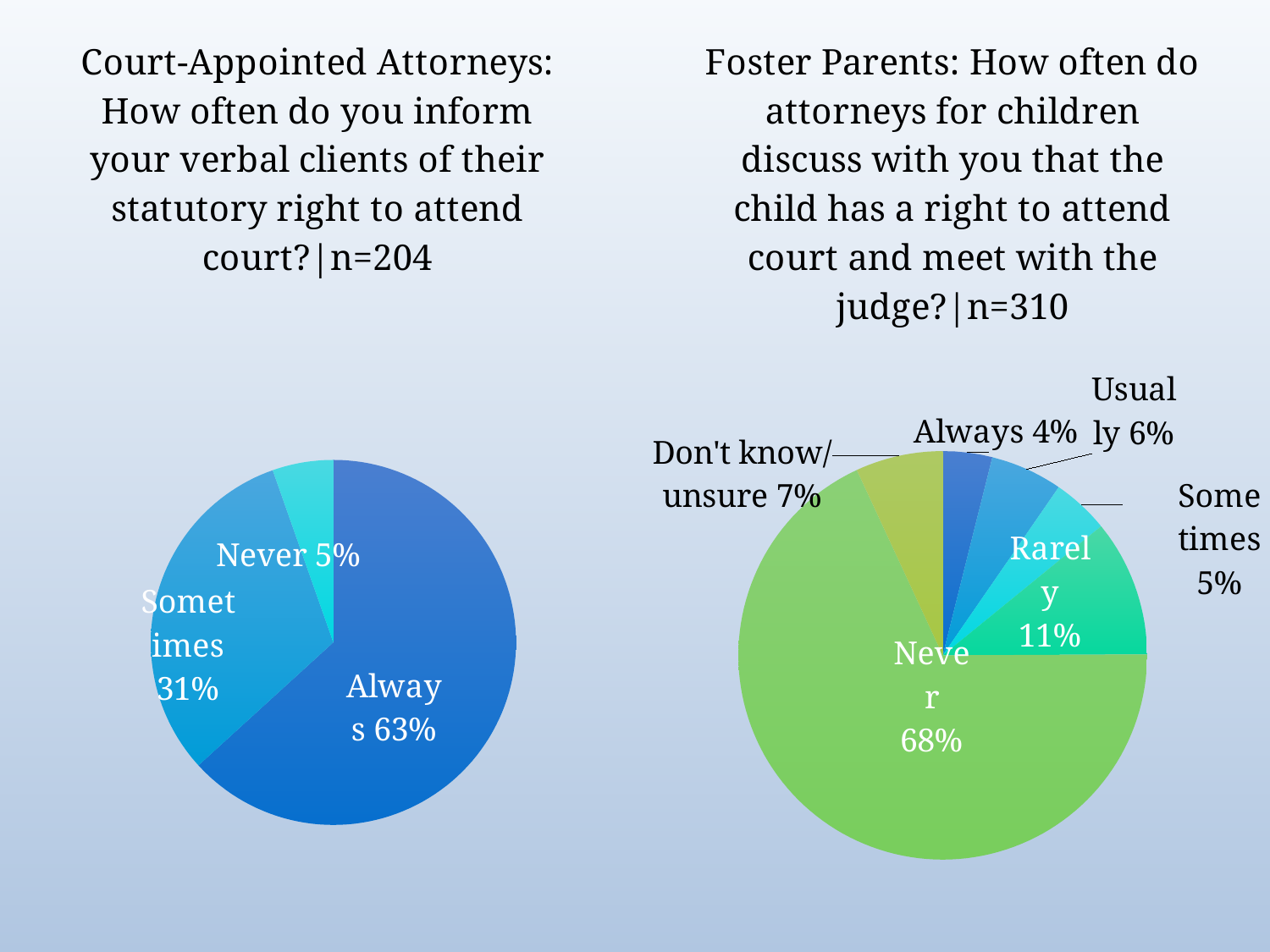
In the Court-Appointed Attorneys chart on the left, which response has the smallest slice? Never In the Court-Appointed Attorneys chart on the left, what share of respondents answered Sometimes? 31% In the Foster Parents chart on the right, how many slices does the pie have? 6 In the Foster Parents chart on the right, which response has the largest slice? Never In the Court-Appointed Attorneys chart on the left, how many slices does the pie have? 3 In the Court-Appointed Attorneys chart on the left, what share of respondents answered Always? 63% In the Court-Appointed Attorneys chart on the left, what is the difference between the Always and Sometimes shares? 32% In the Foster Parents chart on the right, what share of respondents answered Rarely? 11% What type of chart is used on this slide? Pie chart In the Foster Parents chart on the right, what share of respondents answered Never? 68% In the Foster Parents chart on the right, what share of respondents answered Don't know/unsure? 7% In the Foster Parents chart on the right, which is larger, the Usually share or the Always share? Usually